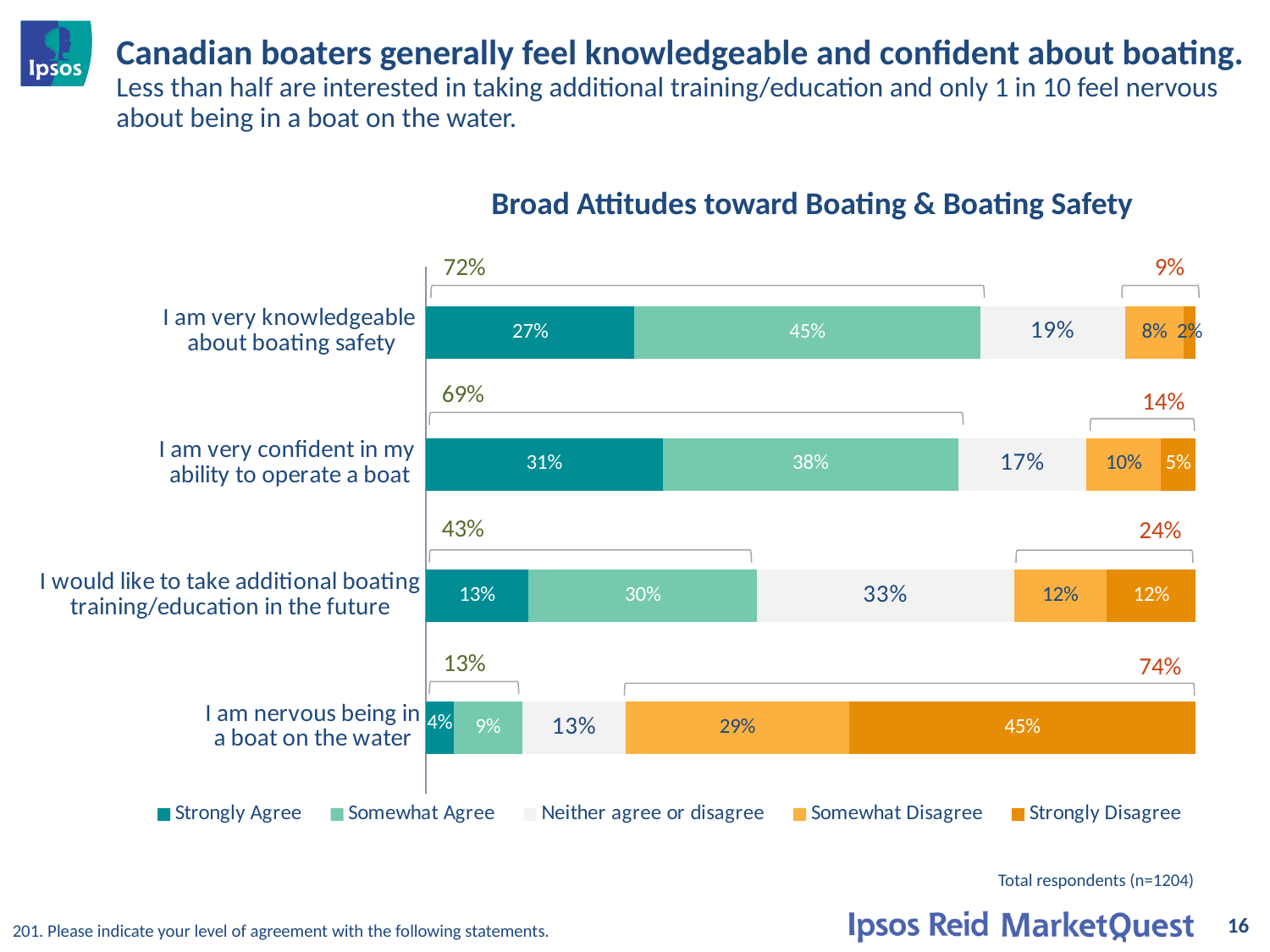
What percentage of respondents neither agree nor disagree that they would like to take additional boating training/education in the future? 33% Which is larger: the Strongly Disagree percentage for 'I would like to take additional boating training/education in the future' or for 'I am very confident in my ability to operate a boat'? I would like to take additional boating training/education in the future What is the title of the chart? Broad Attitudes toward Boating & Boating Safety Which statement has the highest Strongly Agree percentage? I am very confident in my ability to operate a boat What type of chart is shown on the slide? Stacked bar chart Which statement has the lowest Somewhat Agree percentage? I am nervous being in a boat on the water What percentage of respondents strongly agree that they are very knowledgeable about boating safety? 27% What is the difference between the Somewhat Agree percentages for 'I am very knowledgeable about boating safety' and 'I am very confident in my ability to operate a boat'? 7% What percentage of respondents strongly disagree that they are nervous being in a boat on the water? 45% How many statements are shown in the chart? 4 How many series does the legend list? 5 What percentage of respondents somewhat agree that they are very confident in their ability to operate a boat? 38%